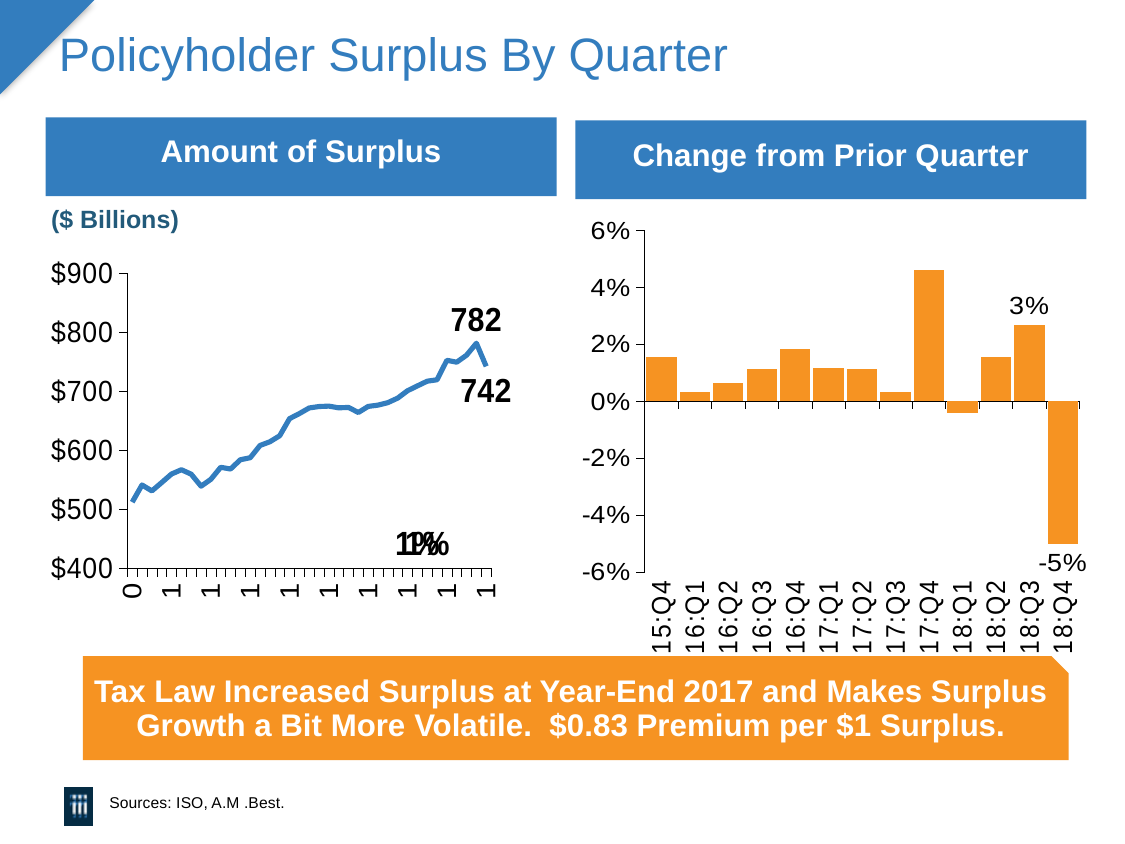
In the 'Change from Prior Quarter' chart, is the value for 15:Q4 greater or less than 2%? less In the 'Change from Prior Quarter' chart, what is the value for 18:Q3? 3% In the 'Amount of Surplus' chart, what unit is shown above the y axis? $ Billions In the 'Amount of Surplus' chart, what is the difference between the labelled peak value 782 and the final value 742? 40 What kind of chart is the 'Amount of Surplus' chart? line chart In the 'Change from Prior Quarter' chart, what is the value for 18:Q4? -5% In the 'Change from Prior Quarter' chart, which quarter has the lowest value? 18:Q4 In the 'Change from Prior Quarter' chart, how many quarters are shown on the x axis? 13 In the 'Change from Prior Quarter' chart, which quarter has the highest value? 17:Q4 In the 'Change from Prior Quarter' chart, how many quarters have a negative value? 2 What kind of chart is the 'Change from Prior Quarter' chart? bar chart In the 'Change from Prior Quarter' chart, is the value for 17:Q4 greater or less than 4%? greater